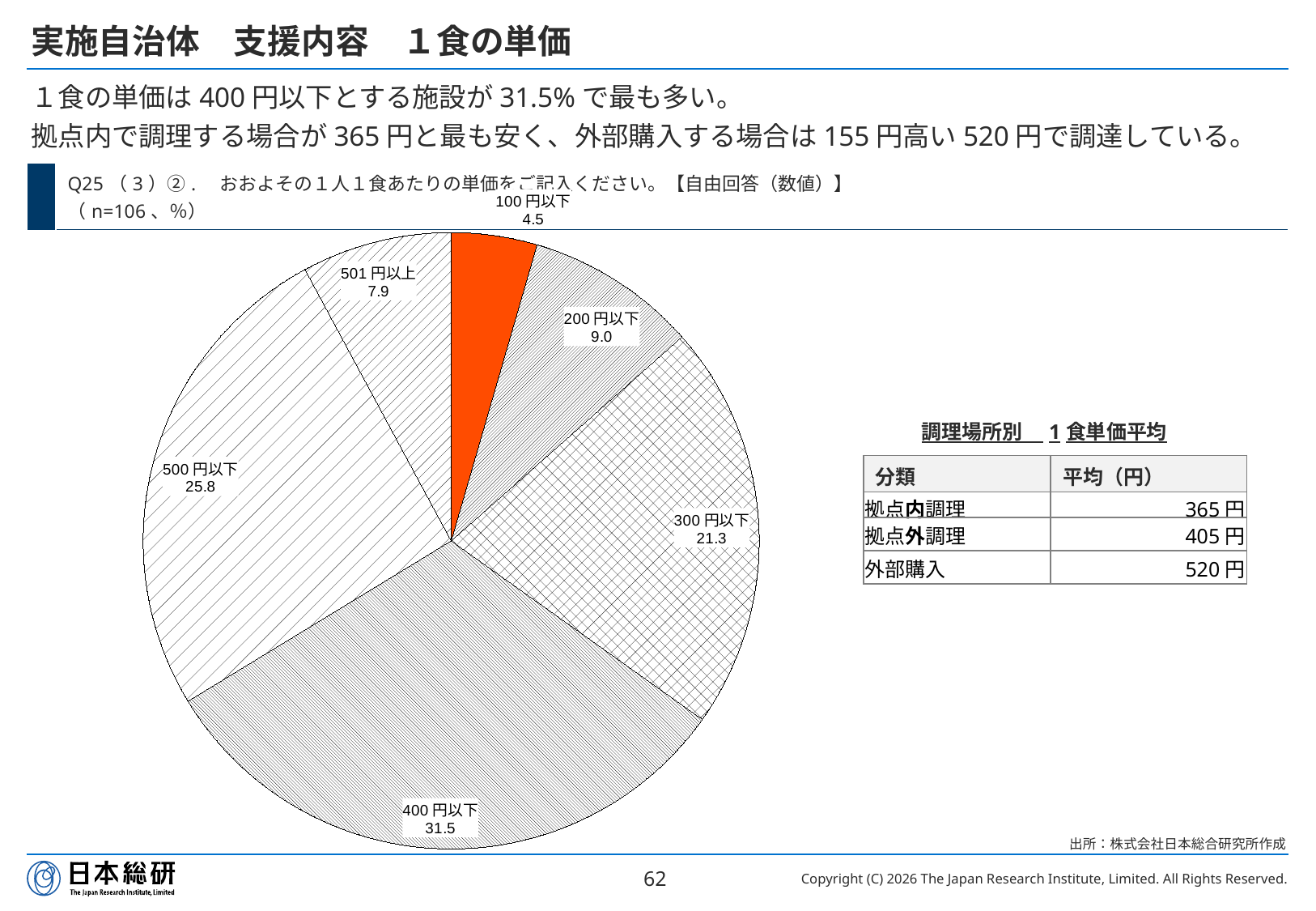
Which category has the smallest share of the pie chart? 100円以下 How many categories are shown in the pie chart? 6 Which is larger in the pie chart, 200円以下 or 501円以上? 200円以下 Which category has the largest share of the pie chart? 400円以下 Which slice of the pie chart is coloured orange? 100円以下 What is the difference between the values for 400円以下 and 500円以下 in the pie chart? 5.7 What is the value for 400円以下 in the pie chart? 31.5 What is the value for 501円以上 in the pie chart? 7.9 What is the value for 500円以下 in the pie chart? 25.8 What is the value for 100円以下 in the pie chart? 4.5 What is the difference between the values for 300円以下 and 200円以下 in the pie chart? 12.3 What kind of chart is shown on the slide? Pie chart